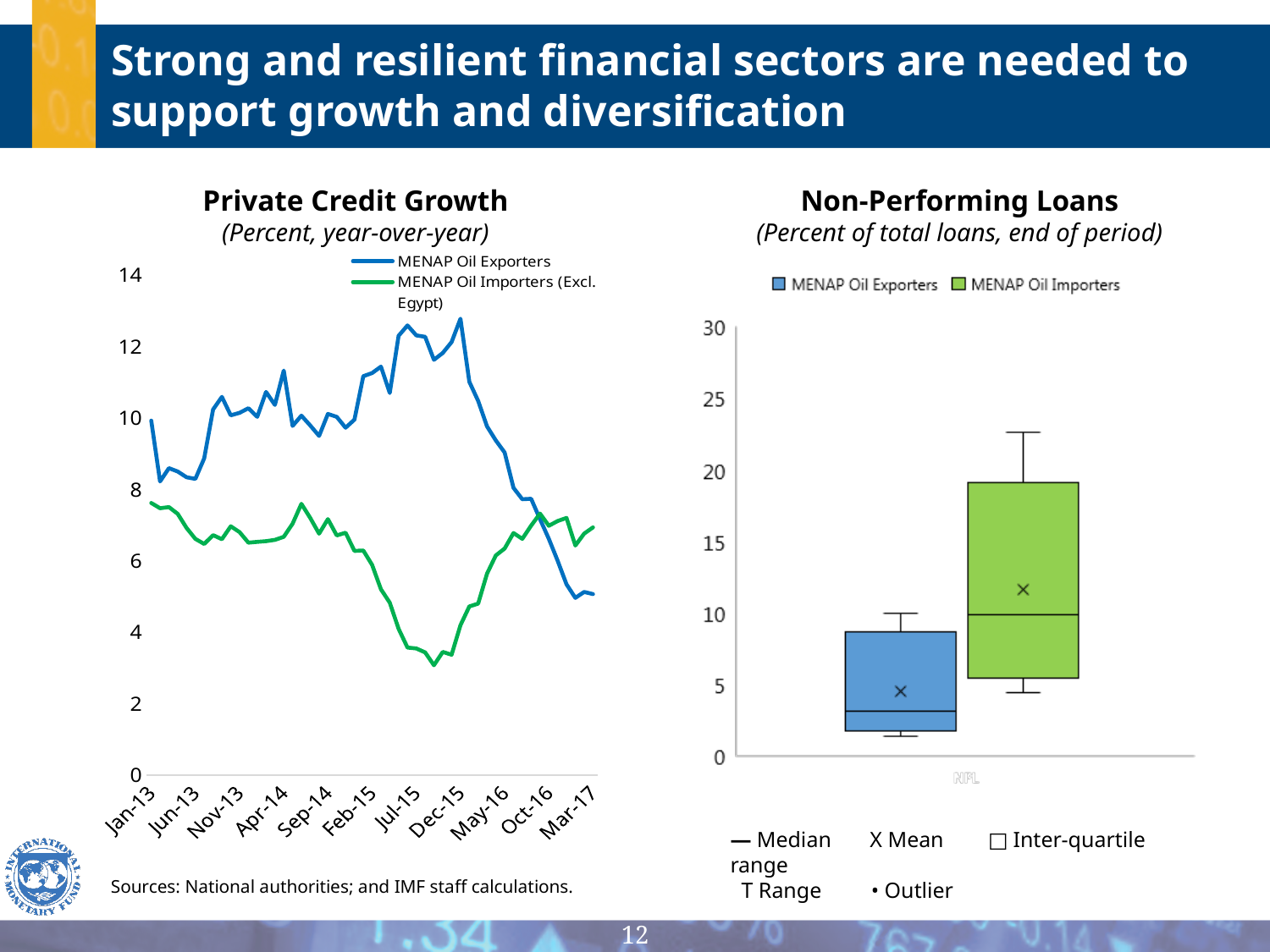
In the Non-Performing Loans chart, is the mean for MENAP Oil Importers greater or less than 10? greater In the Private Credit Growth chart, is the value for MENAP Oil Exporters at Mar-17 greater or less than 6? less In the Non-Performing Loans chart, which group has the higher median? MENAP Oil Importers In the Private Credit Growth chart, which series has the higher value at Jan-13? MENAP Oil Exporters What kind of chart is the Non-Performing Loans chart? Box plot How many series does the legend of the Private Credit Growth chart list? 2 What kind of chart is the Private Credit Growth chart? Line chart In the Private Credit Growth chart, is the value for MENAP Oil Exporters at Jan-13 greater or less than 8? greater In the Private Credit Growth chart, does the MENAP Oil Exporters line rise or fall between Dec-15 and Mar-17? Fall In the Private Credit Growth chart, which series has the higher value at Mar-17? MENAP Oil Importers (Excl. Egypt) How many series does the legend of the Non-Performing Loans chart list? 2